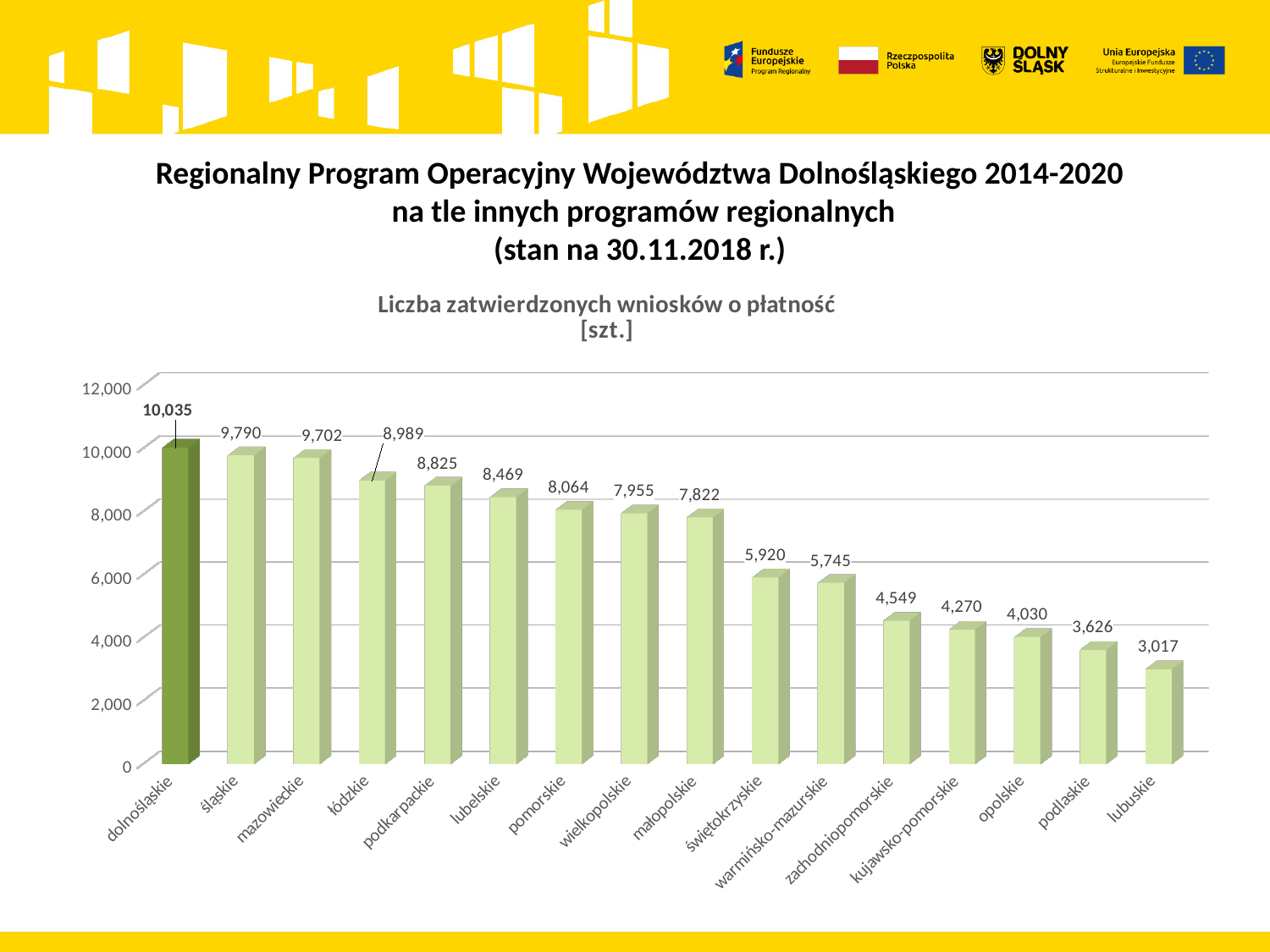
What is the difference between the values for dolnośląskie and śląskie? 245 Is the value for opolskie greater or less than 4,000? greater What is the value for lubuskie? 3,017 How many regions are shown on the chart? 16 Which region has the highest number of approved payment applications? dolnośląskie What is the difference between the values for świętokrzyskie and warmińsko-mazurskie? 175 Which is larger, the value for pomorskie or the value for wielkopolskie? pomorskie What kind of chart is shown on the slide? bar chart What is the value for małopolskie? 7,822 What is the value for dolnośląskie? 10,035 Which region has the lowest number of approved payment applications? lubuskie What is the title of the chart? Liczba zatwierdzonych wniosków o płatność [szt.]